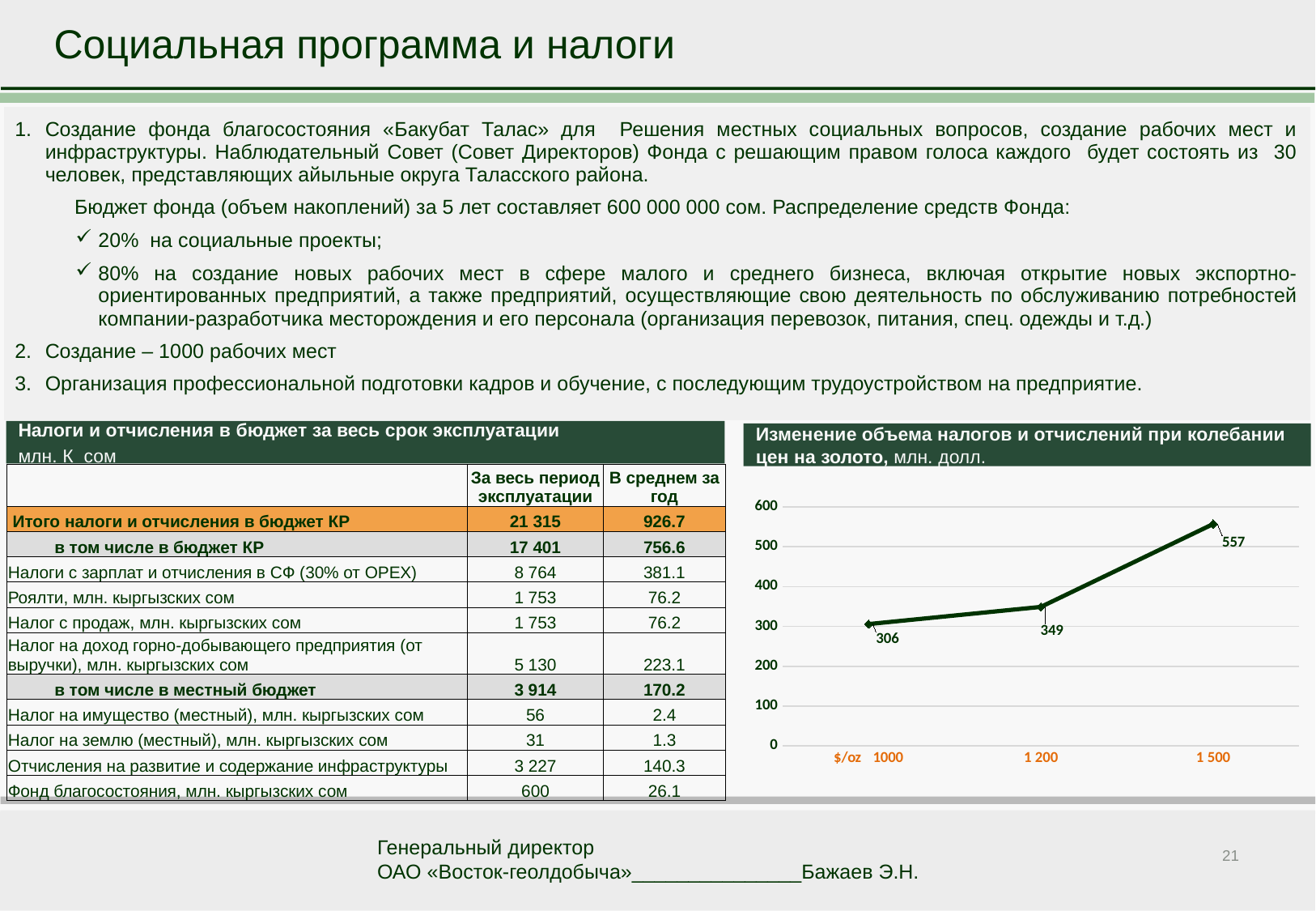
How many data points are plotted on the line chart? 3 At which gold price is the value of taxes and deductions lowest? 1000 What is the value of taxes and deductions at a gold price of 1 200 $/oz? 349 What is the value of taxes and deductions at a gold price of 1000 $/oz? 306 What is the value of taxes and deductions at a gold price of 1 500 $/oz? 557 Do the values rise or fall as the gold price increases along the x axis? rise Which is larger: the value at 1 200 $/oz or the value at 1 500 $/oz? 1 500 What is the difference between the values at 1 200 $/oz and 1000 $/oz? 43 What type of chart is shown on the slide? line chart At which gold price is the value of taxes and deductions highest? 1 500 What is the difference between the values at 1 500 $/oz and 1000 $/oz? 251 Is the value at 1 500 $/oz greater or less than 500? greater